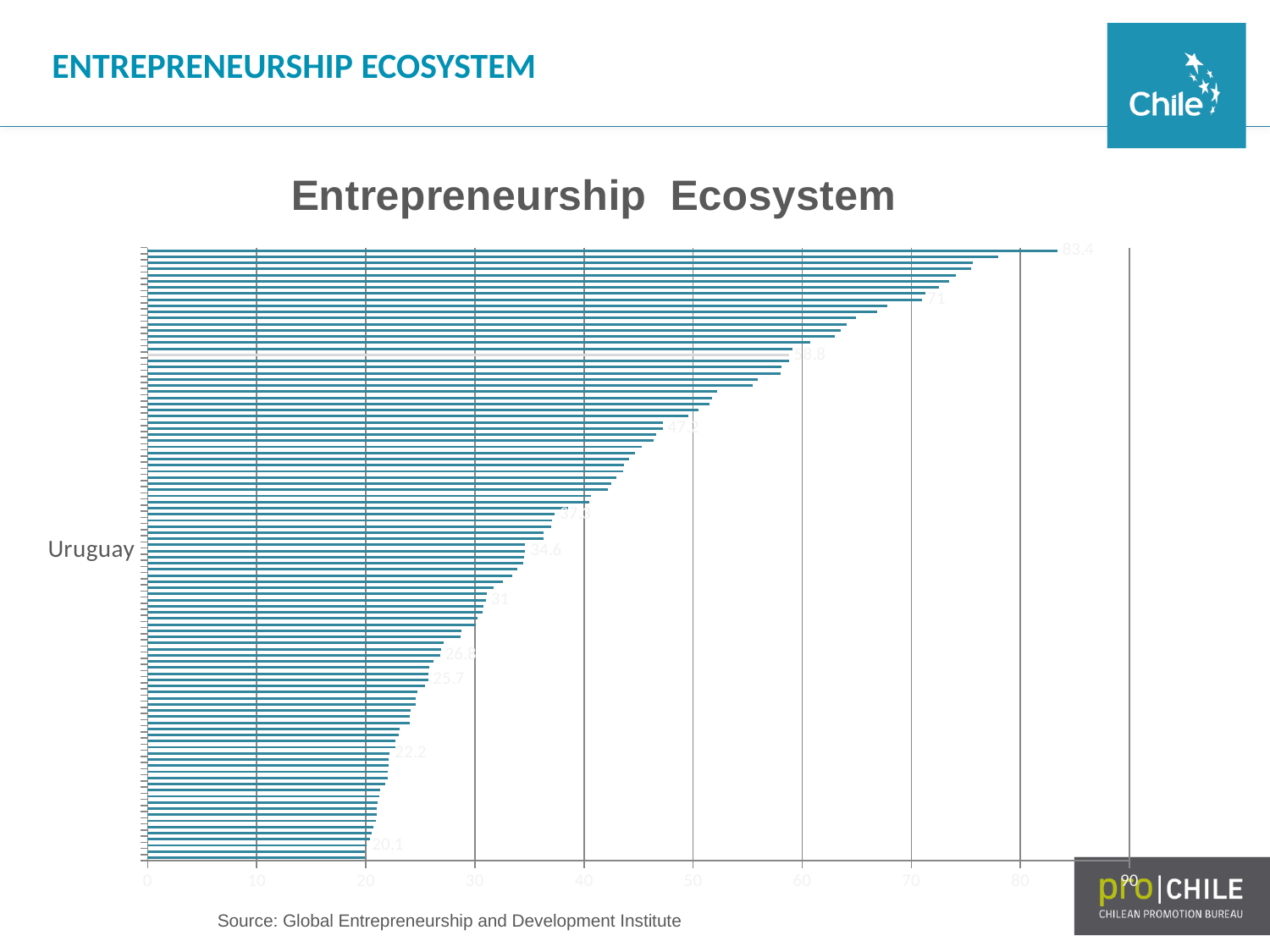
What is the lowest value labelled on the chart? 20.1 What kind of chart is shown on the slide? bar chart What is the highest tick value shown on the horizontal axis? 90 Is the value for Uruguay greater or less than 40? less Which is larger, the value of the top bar or the value of the bottom bar? the top bar What is the highest value labelled on the chart? 83.4 Do the bar values increase or decrease going from the top of the chart to the bottom? decrease What is the title of the chart? Entrepreneurship Ecosystem What is the difference between the highest labelled value (83.4) and the lowest labelled value (20.1)? 63.3 Is the value for Uruguay greater or less than 30? greater Is the longest bar on the chart greater or less than 80? greater